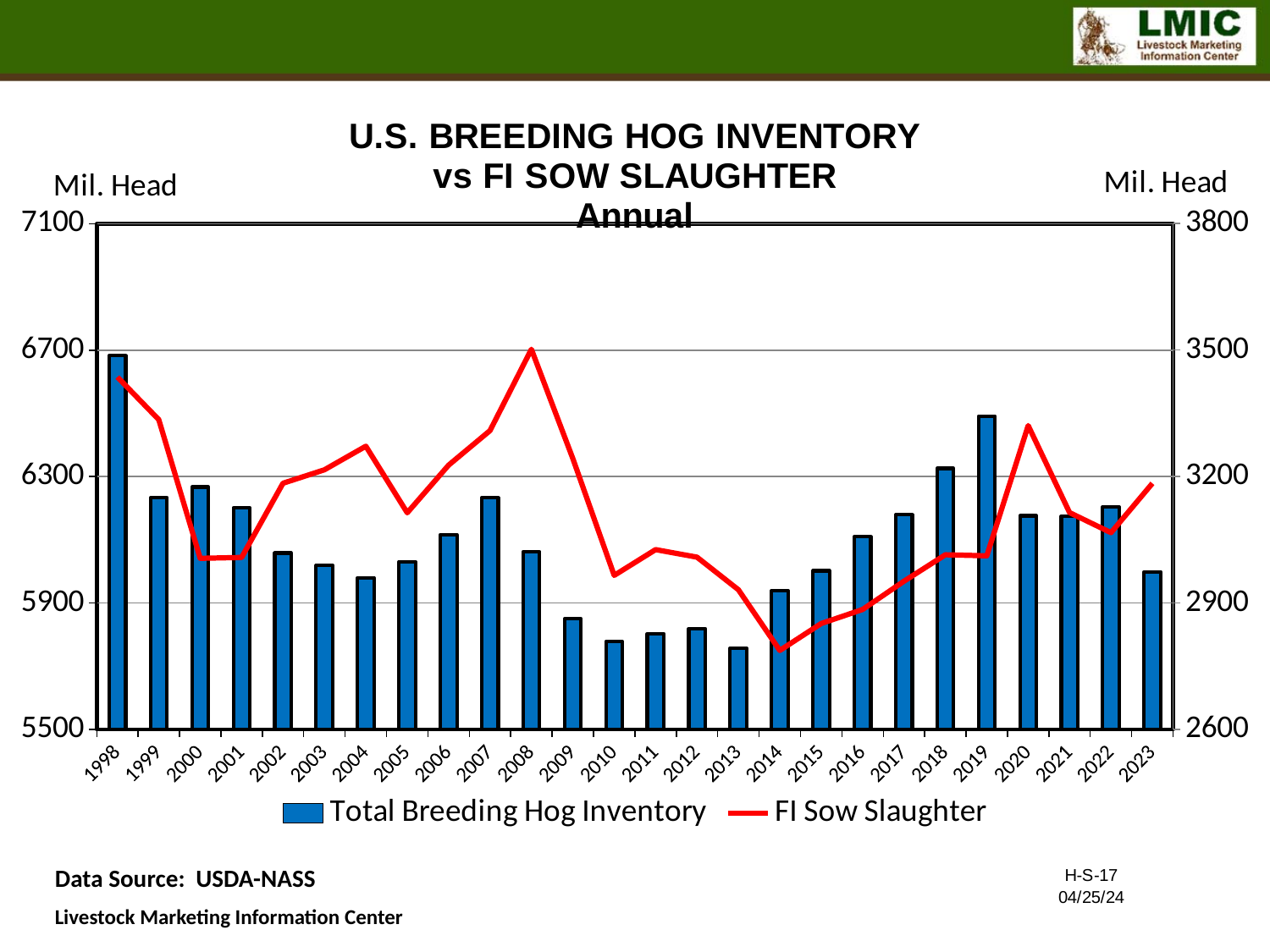
How many years are shown along the x axis? 26 In which year does the FI Sow Slaughter line reach its lowest point? 2014 In which year does the FI Sow Slaughter line reach its highest point? 2008 Which year has the highest Total Breeding Hog Inventory bar? 1998 Is the FI Sow Slaughter value for 2014 greater or less than 2900? less Does the Total Breeding Hog Inventory rise or fall from 2008 to 2013? Fall Which year has the larger Total Breeding Hog Inventory, 2018 or 2019? 2019 What kind of chart is shown on the slide? A combined bar and line chart How many series does the legend list? 2 What are the two series named in the legend? Total Breeding Hog Inventory and FI Sow Slaughter Is the Total Breeding Hog Inventory for 2013 greater or less than 5900? less Is the Total Breeding Hog Inventory for 1998 greater or less than 6300? greater